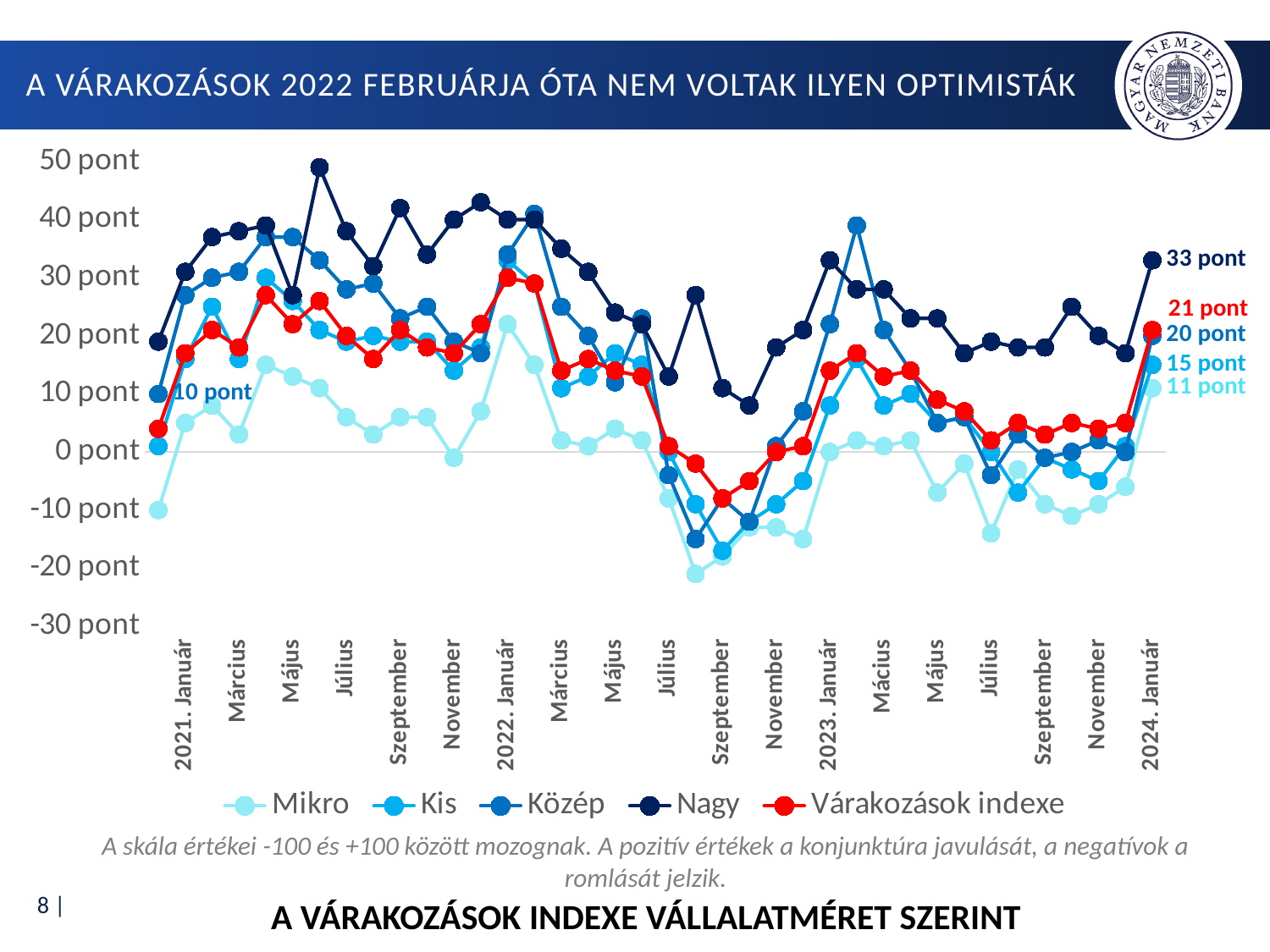
What is the value of the Mikro series in 2024. Január? 11 pont What is the value of the Várakozások indexe series in 2024. Január? 21 pont What kind of chart is shown on the slide? line chart Is the value of the Nagy series in Május 2021 greater or less than 40 pont? less How many series does the legend list? 5 What is the value of the Közép series in 2024. Január? 20 pont What is the value of the Kis series in 2024. Január? 15 pont Which series has the lowest value in 2024. Január? Mikro What is the value of the Nagy series in 2024. Január? 33 pont What is the difference between the Nagy and Mikro values in 2024. Január? 22 pont Which series has the highest value in 2024. Január? Nagy